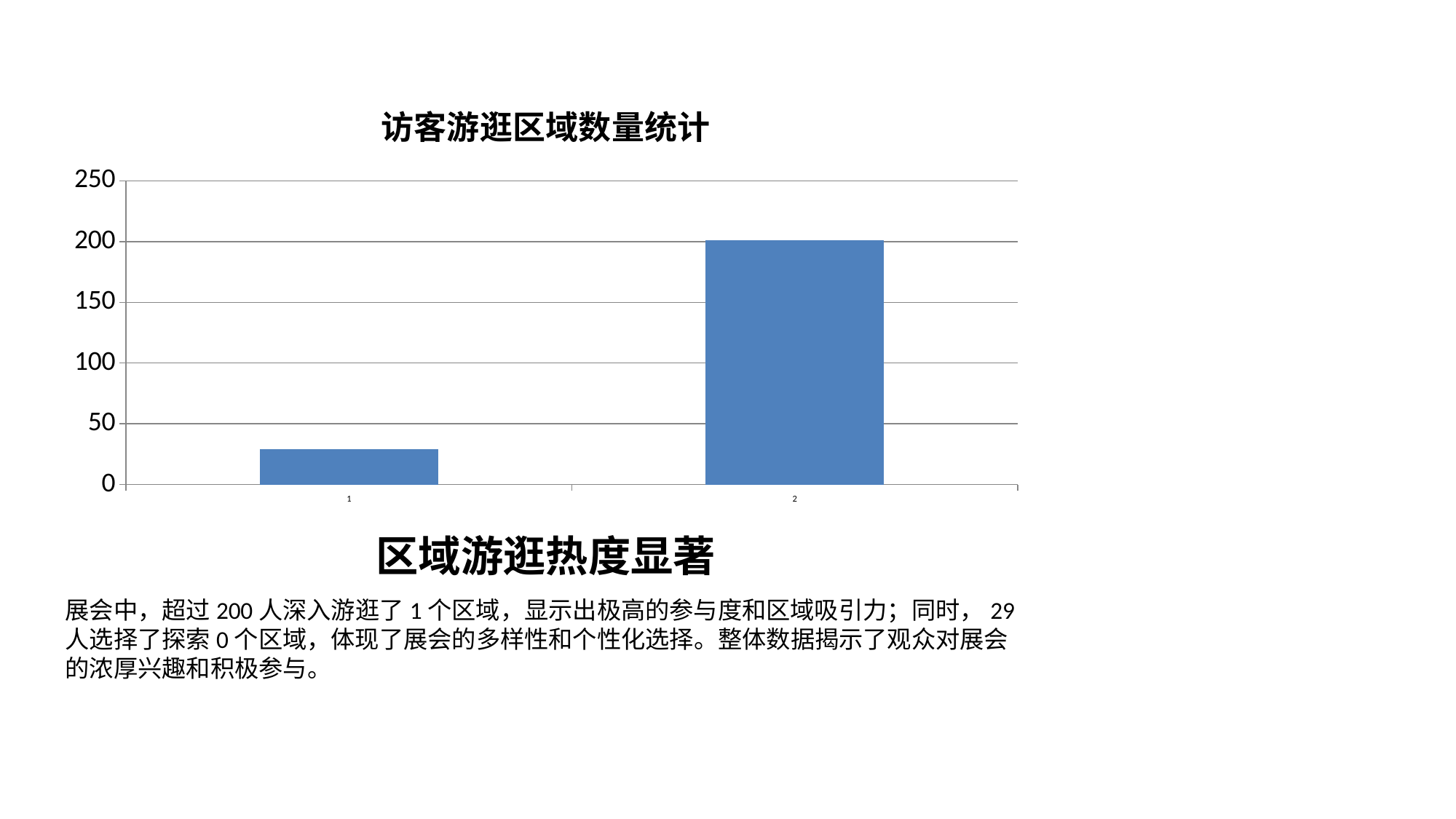
Which category has the highest bar? 2 Is the value for category 2 greater or less than 250? less Which is larger, the value for category 1 or category 2? 2 How many bars are plotted in the chart? 2 Is the value for category 1 greater or less than 50? less What is the highest value shown on the vertical axis? 250 Is the value for category 2 greater or less than 150? greater Which category has the lowest bar? 1 Do the bar values rise or fall from category 1 to category 2? rise What kind of chart is shown on the slide? bar chart What is the title of the chart? 访客游逛区域数量统计